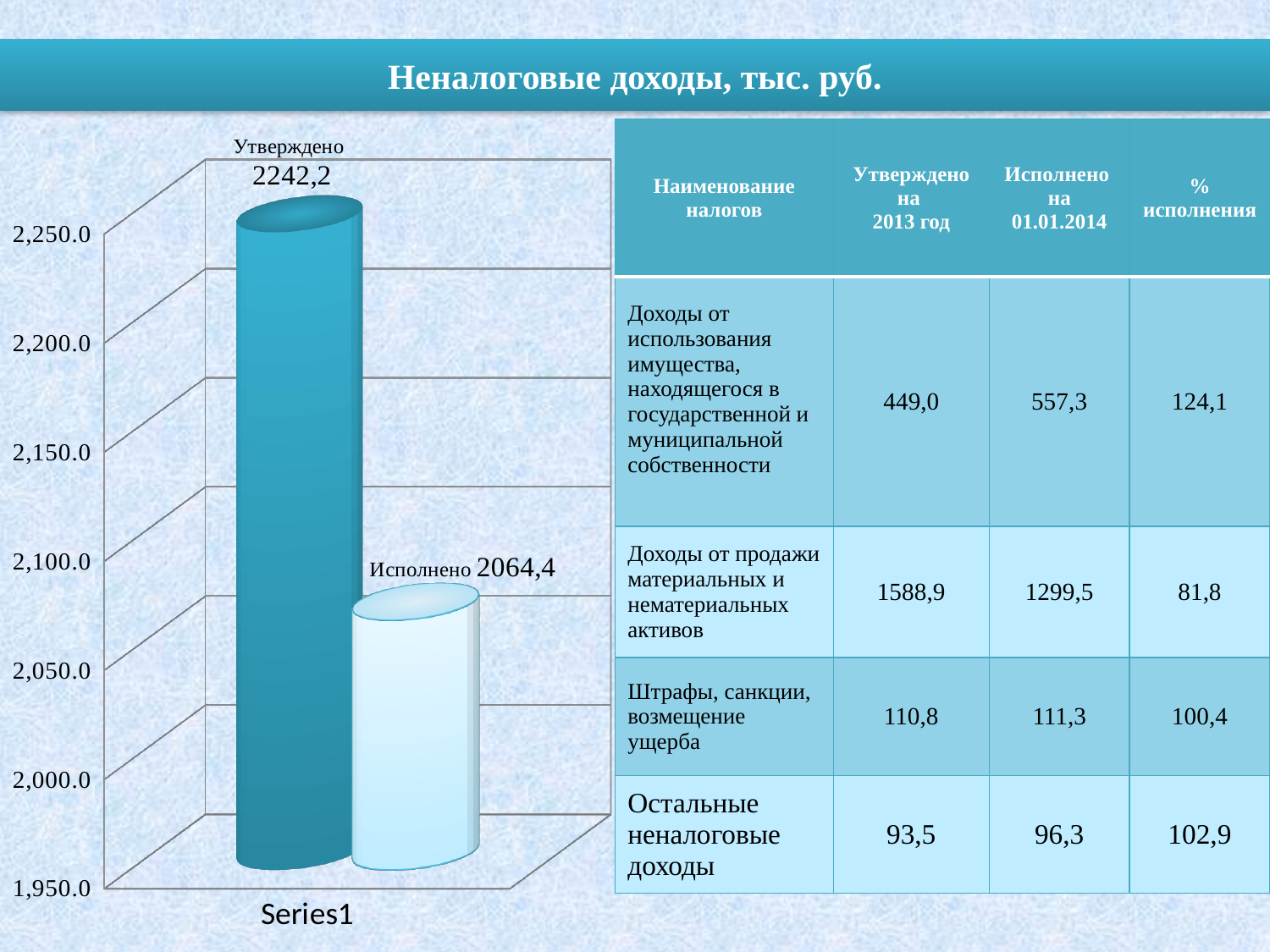
How many bars are plotted in the chart? 2 Which bar in the chart is the lowest? Исполнено Is the value for Утверждено greater or less than 2,200.0? greater Which bar in the chart is the highest? Утверждено What is the value of the Утверждено bar in the chart? 2242,2 Which is larger in the chart, Утверждено or Исполнено? Утверждено What kind of chart is shown on the slide? bar chart What is the title shown at the top of the slide above the chart? Неналоговые доходы, тыс. руб. Is the value for Исполнено greater or less than 2,100.0? less What label appears on the horizontal axis of the chart? Series1 What is the difference between the Утверждено and Исполнено values in the chart? 177,8 What is the value of the Исполнено bar in the chart? 2064,4